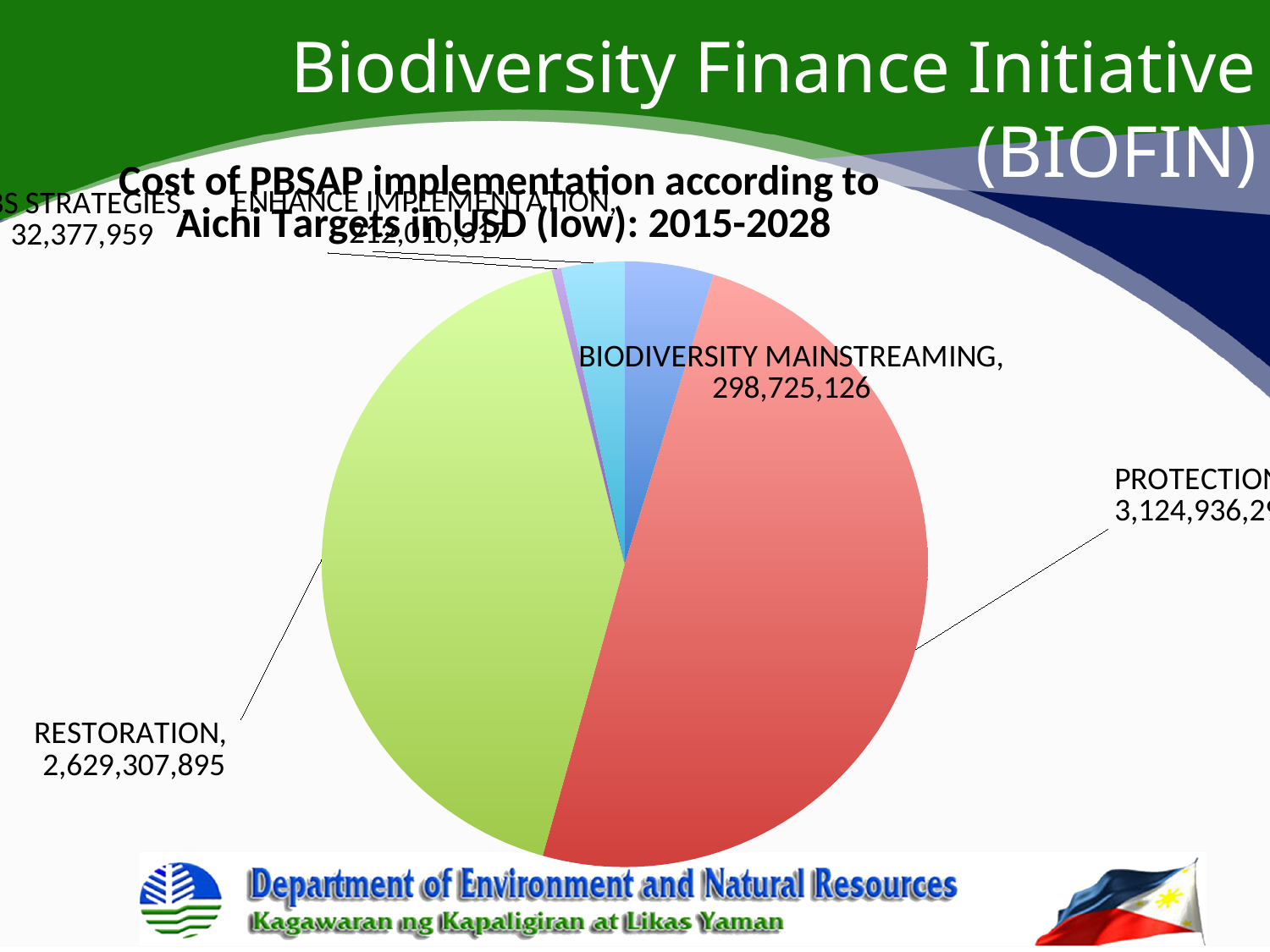
What is the difference between the RESTORATION value and the BIODIVERSITY MAINSTREAMING value? 2,330,582,769 What kind of chart is shown on the slide? Pie chart What is the value for RESTORATION in the pie chart? 2,629,307,895 Which category has the largest slice of the pie chart? PROTECTION Which is larger, the PROTECTION slice or the RESTORATION slice? PROTECTION What is the title of the chart? Cost of PBSAP implementation according to Aichi Targets in USD (low): 2015-2028 How many slices does the pie chart have? 5 Which is larger, the RESTORATION slice or the BIODIVERSITY MAINSTREAMING slice? RESTORATION What is the value for BIODIVERSITY MAINSTREAMING in the pie chart? 298,725,126 What colour is the PROTECTION slice of the pie chart? Red